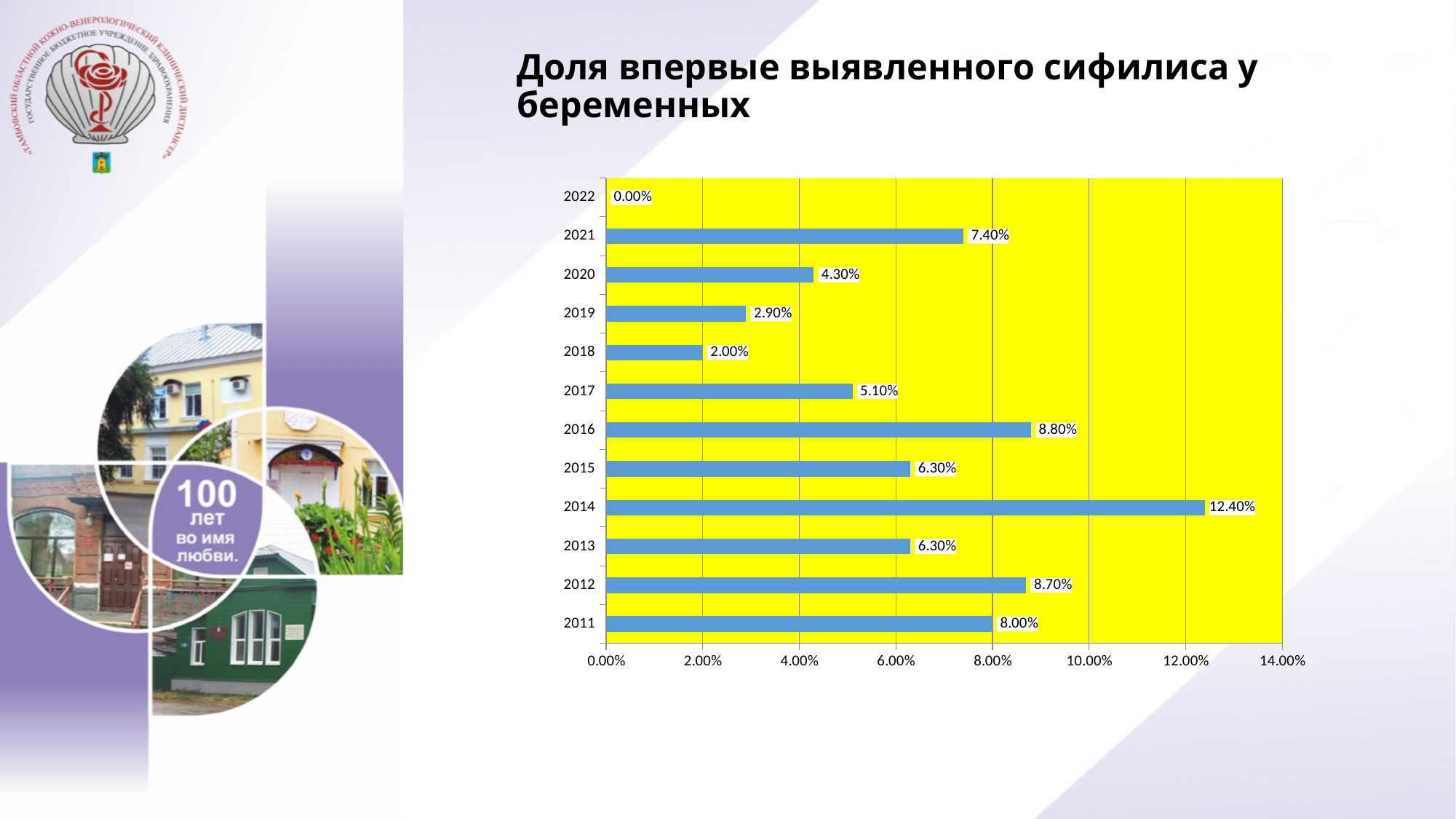
What kind of chart is shown on the slide? bar chart What is the value for 2021? 7.40% Is the value for 2017 greater or less than 4.00%? greater Which year has the highest value? 2014 What is the value for 2018? 2.00% How many years are shown on the chart? 12 What is the title of the chart? Доля впервые выявленного сифилиса у беременных Which is larger, the value for 2012 or the value for 2016? 2016 What is the difference between the values for 2014 and 2015? 6.10% Do the values rise or fall from 2018 to 2021? rise What is the value for 2014? 12.40% Which year has the lowest value? 2022